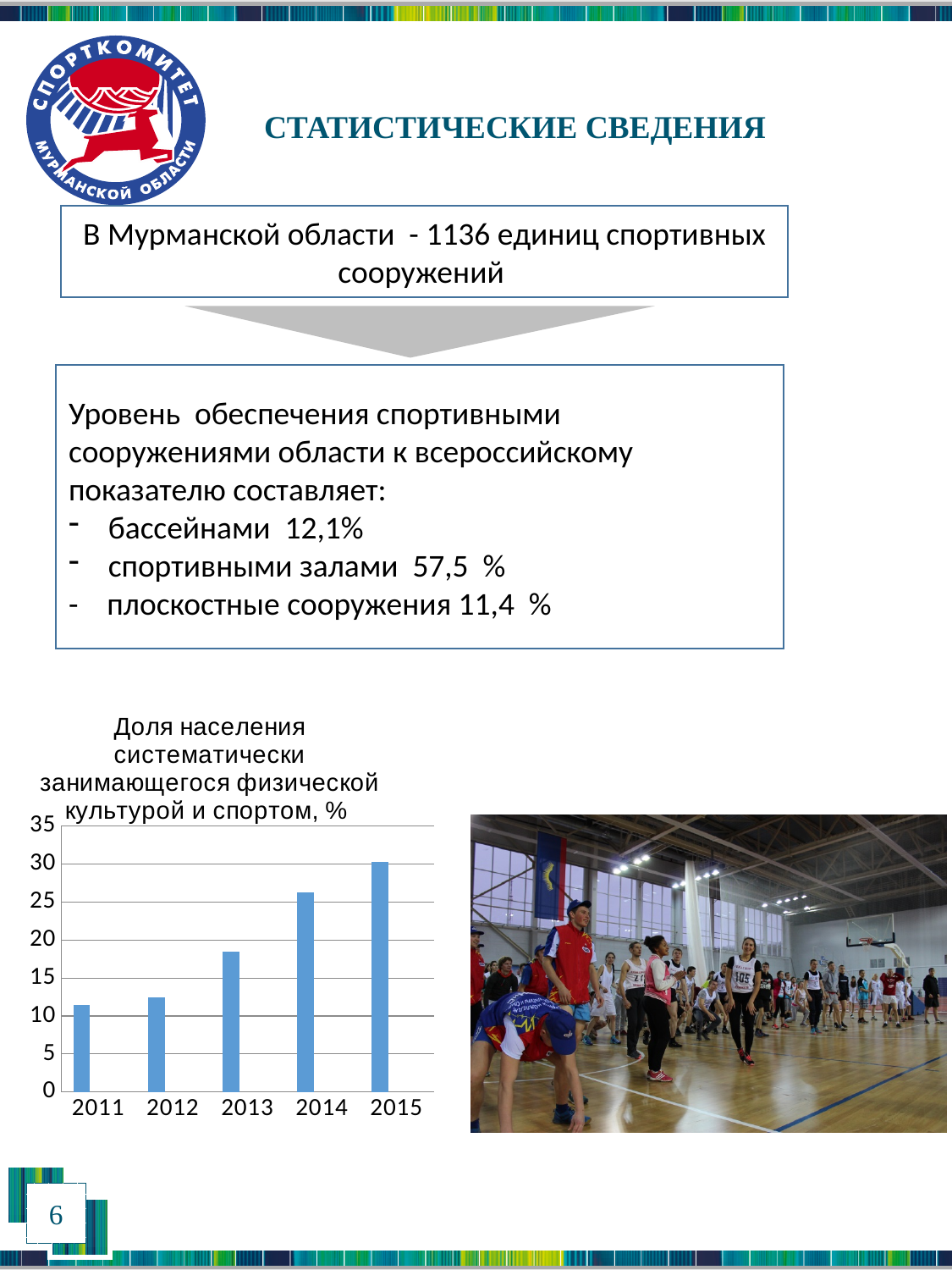
Which is larger, the value for 2012 or the value for 2015? 2015 Is the value for 2013 greater or less than 15? greater How many years are shown on the x axis of the chart? 5 Which year has the highest value in the chart? 2015 Is the value for 2011 greater or less than 15? less Which year has the lowest value in the chart? 2011 Do the values in the chart rise or fall from 2011 to 2015? rise What is the highest value shown on the chart's vertical axis? 35 Which is larger, the value for 2013 or the value for 2014? 2014 Is the value for 2015 greater or less than 25? greater What kind of chart is shown on the slide? bar chart